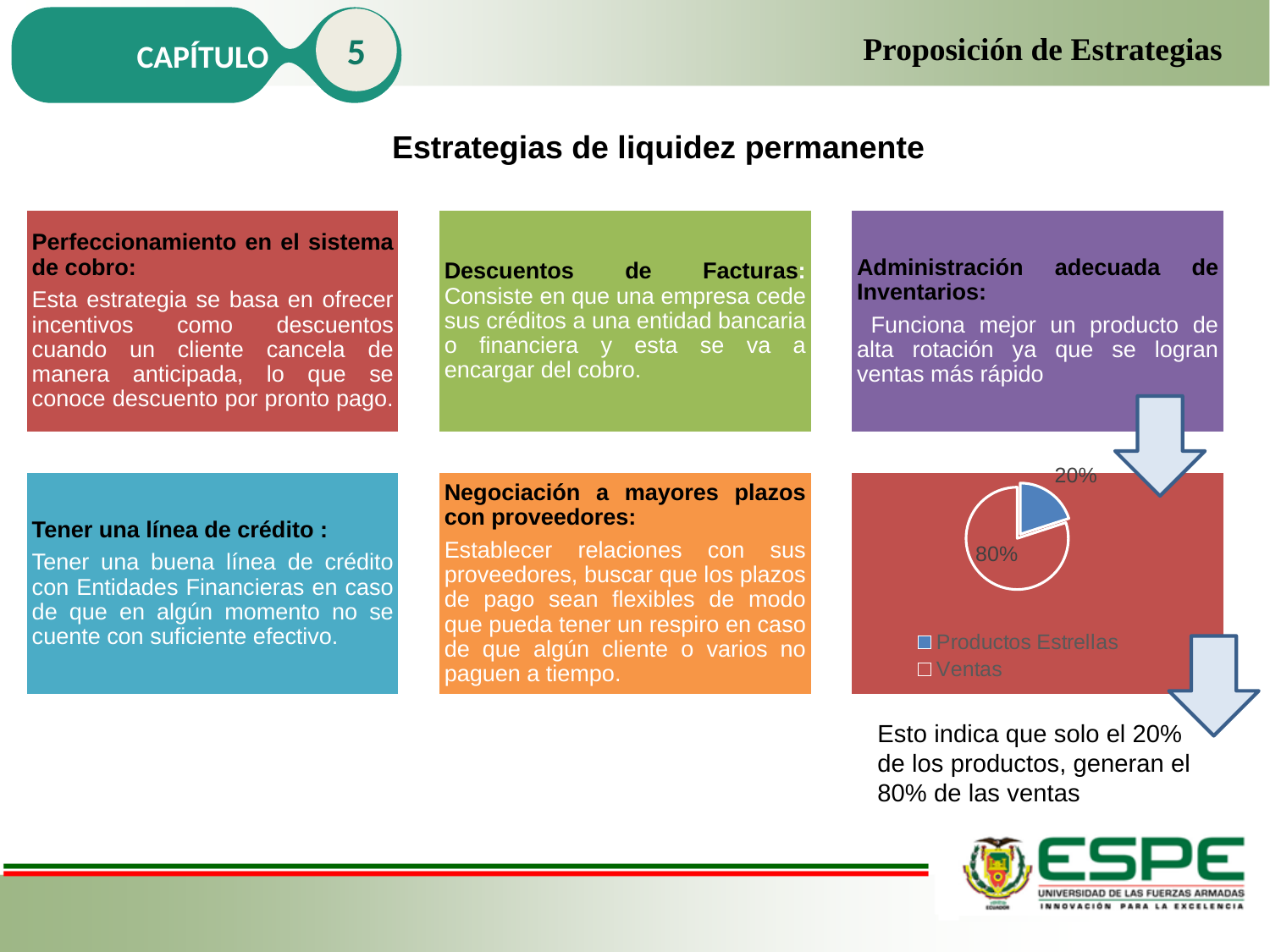
How many slices does the pie chart have? 2 What share of the pie does the Ventas slice represent? 80% Which is larger in the pie chart, Productos Estrellas or Ventas? Ventas How many entries does the legend of the pie chart list? 2 What are the two legend entries of the pie chart? Productos Estrellas and Ventas What kind of chart is shown on the slide? pie chart Which slice of the pie chart is the largest? Ventas Which slice of the pie chart is the smallest? Productos Estrellas What is the difference in percentage points between the Ventas slice and the Productos Estrellas slice? 60 What colour is the Productos Estrellas slice in the pie chart? blue What share of the pie does the Productos Estrellas slice represent? 20% Is the share for Productos Estrellas greater or less than 50%? less